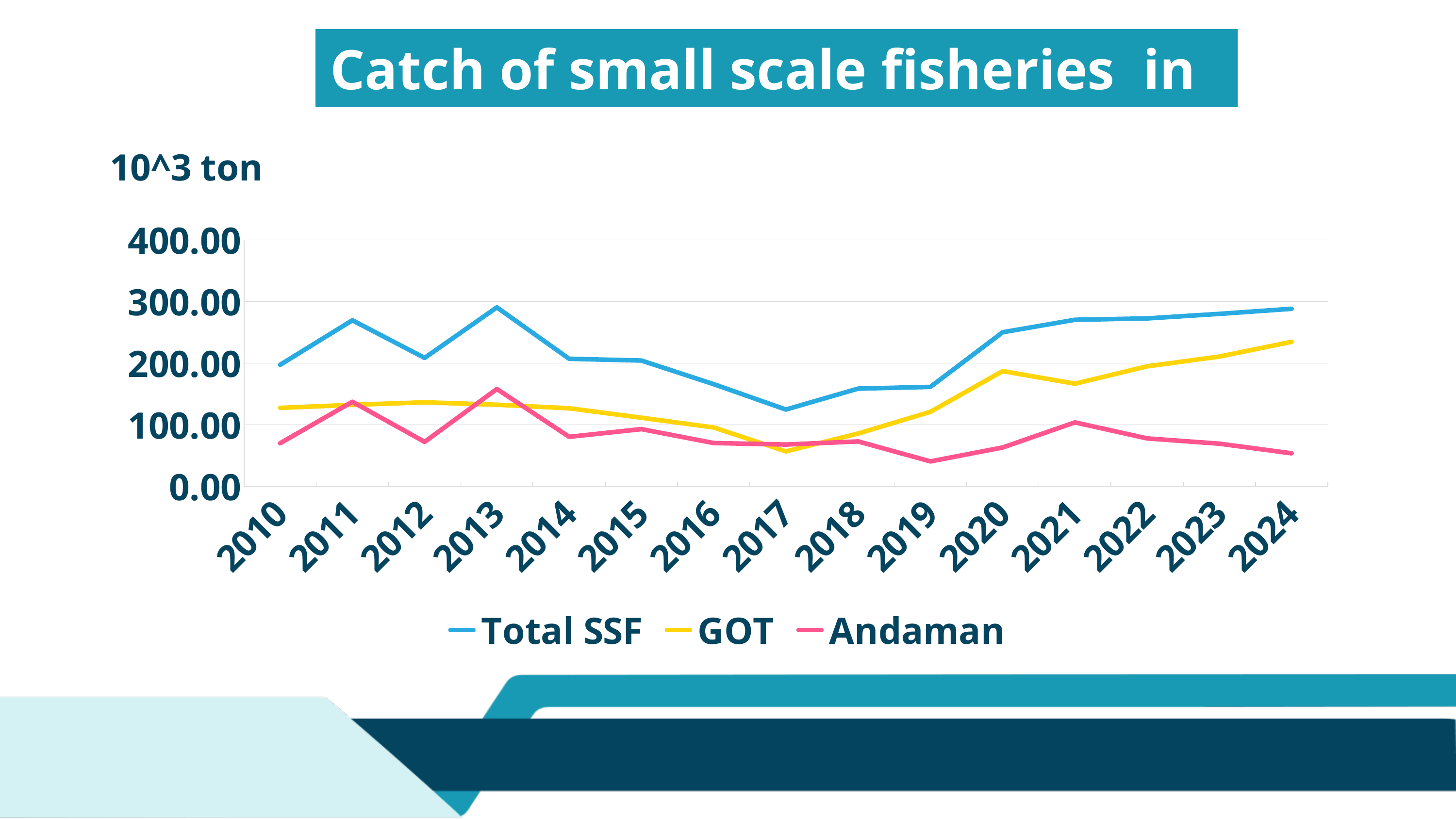
Is the Total SSF value for 2017 greater or less than 200.00? less In which year is the GOT value highest? 2024 In which year is the Andaman value lowest? 2019 Does the Total SSF line rise or fall from 2020 to 2024? rise How many series does the legend list? 3 In which year is the Andaman value highest? 2013 What unit label is shown above the y axis? 10^3 ton Is the GOT value for 2024 greater or less than 200.00? greater In which year is the Total SSF value lowest? 2017 What kind of chart is shown on the slide? line chart How many years are shown on the x axis? 15 In 2024, which is larger, the GOT value or the Andaman value? GOT